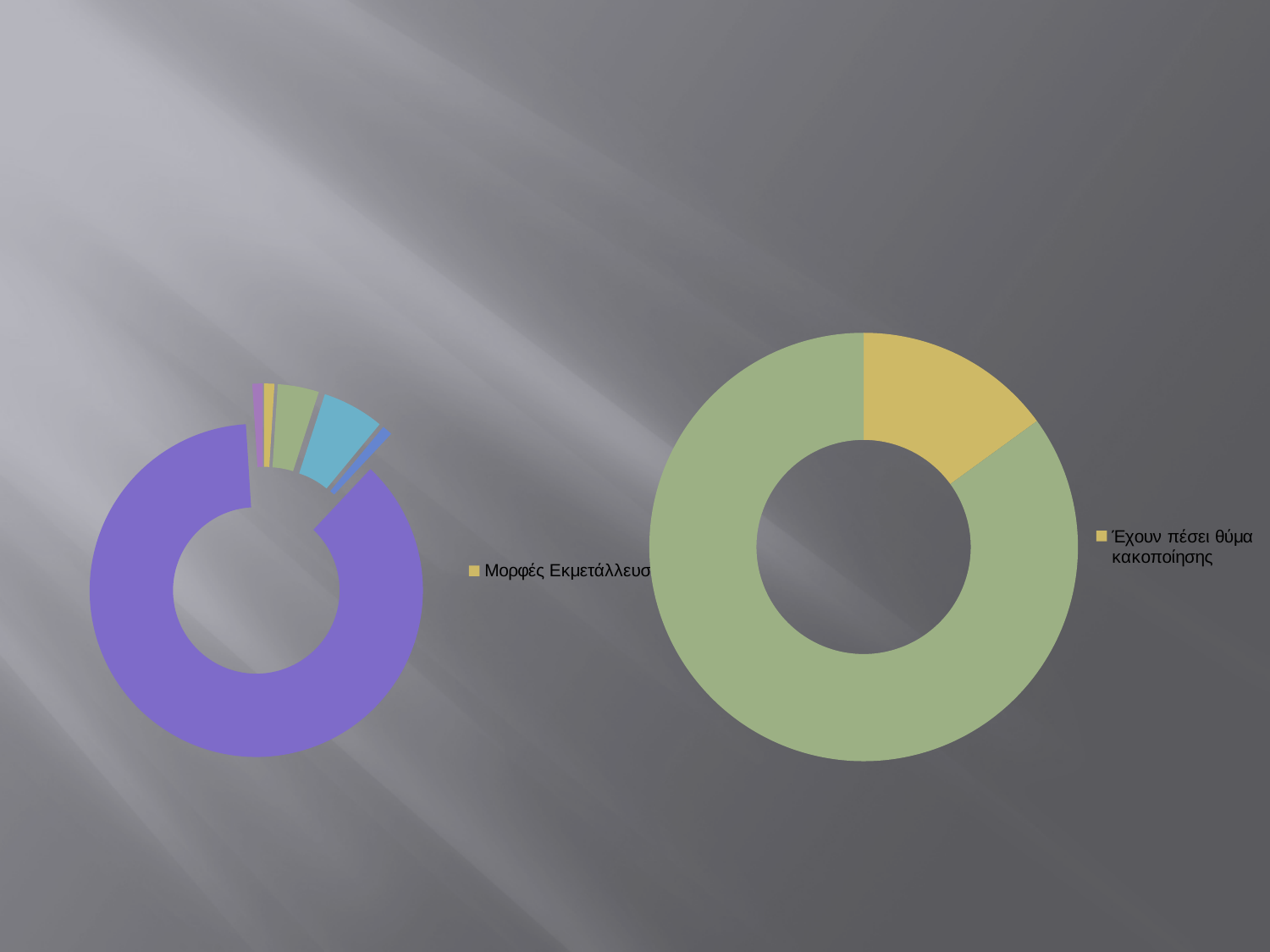
In the chart on the right of the slide, does the yellow slice take up more or less than half of the doughnut? Less In the chart on the right of the slide, is the yellow slice larger or smaller than the green slice? Smaller What kind of chart is the chart on the right of the slide? Doughnut chart In the chart on the left of the slide, is the purple slice larger or smaller than the cyan slice? Larger In the chart on the left of the slide, which colour slice is the largest? Purple In the chart on the right of the slide, how many slices does the doughnut have? 2 What text does the legend of the chart on the right of the slide show? Έχουν πέσει θύμα κακοποίησης How many entries does the legend of the chart on the right of the slide list? 1 In the chart on the right of the slide, which colour slice is the smallest? Yellow In the chart on the left of the slide, how many slices does the doughnut have? 6 In the chart on the right of the slide, which colour slice is the largest? Green What kind of chart is the chart on the left of the slide? Doughnut chart